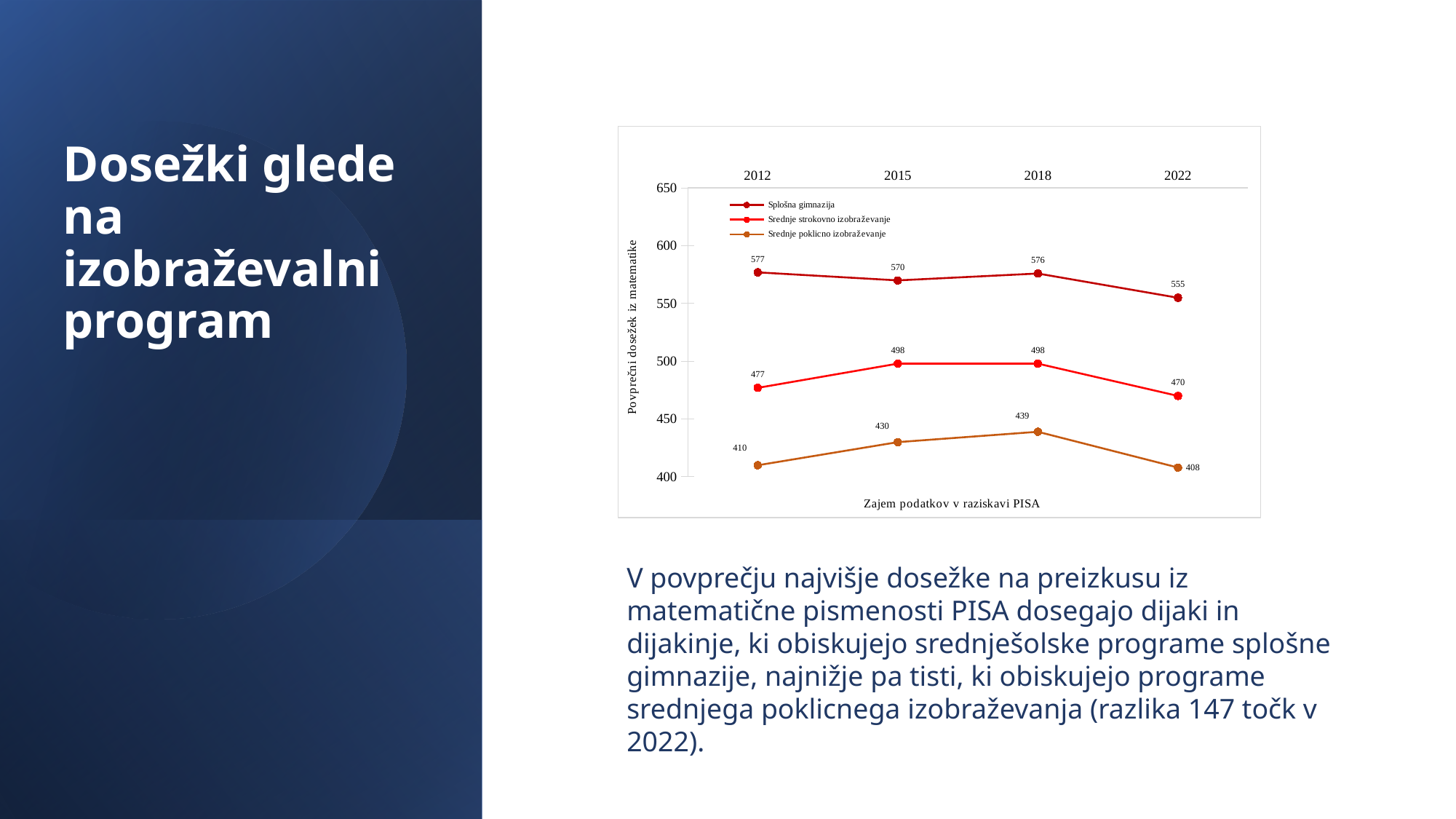
What is the value for Splošna gimnazija in 2012? 577 Does the value for Splošna gimnazija fall or rise from 2018 to 2022? fall How many data collection years are shown on the x axis? 4 What is the label of the y axis? Povprečni dosežek iz matematike Which is larger in 2015: Srednje strokovno izobraževanje or Srednje poklicno izobraževanje? Srednje strokovno izobraževanje What is the value for Srednje poklicno izobraževanje in 2018? 439 How many series does the legend list? 3 In which year is the value for Splošna gimnazija highest? 2012 What is the difference between Splošna gimnazija and Srednje poklicno izobraževanje in 2022? 147 In which year is the value for Srednje poklicno izobraževanje lowest? 2022 What is the value for Srednje strokovno izobraževanje in 2022? 470 What type of chart is shown on the slide? line chart